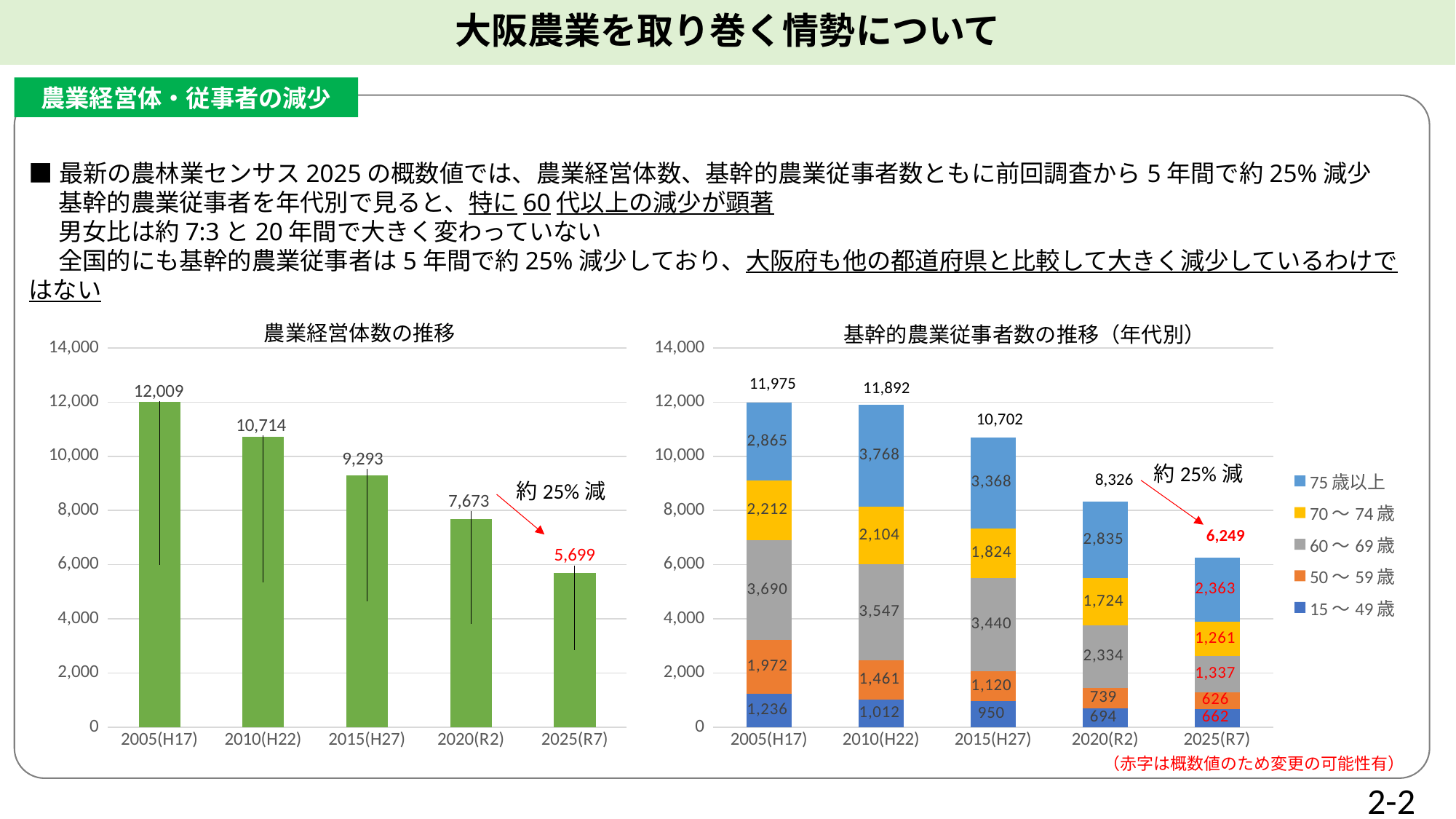
In the chart titled 農業経営体数の推移, what is the difference between the values for 2020(R2) and 2025(R7)? 1,974 In the chart titled 基幹的農業従事者数の推移（年代別）, what is the value of the 60～69歳 segment for 2015(H27)? 3,440 In the chart titled 農業経営体数の推移, which year has the lowest value? 2025(R7) In the chart titled 基幹的農業従事者数の推移（年代別）, how many series does the legend list? 5 In the chart titled 基幹的農業従事者数の推移（年代別）, what is the value of the 75歳以上 segment for 2010(H22)? 3,768 In the chart titled 農業経営体数の推移, what is the value for 2005(H17)? 12,009 In the chart titled 基幹的農業従事者数の推移（年代別）, what is the total of the stacked bar for 2020(R2)? 8,326 In the chart titled 農業経営体数の推移, how many years are plotted? 5 In the chart titled 農業経営体数の推移, what is the value for 2025(R7)? 5,699 What kind of chart is the chart titled 基幹的農業従事者数の推移（年代別）? stacked bar chart In the chart titled 基幹的農業従事者数の推移（年代別）, which is larger for 2025(R7): the 70～74歳 segment or the 50～59歳 segment? 70～74歳 In the chart titled 農業経営体数の推移, do the values rise or fall from 2005(H17) to 2025(R7)? fall